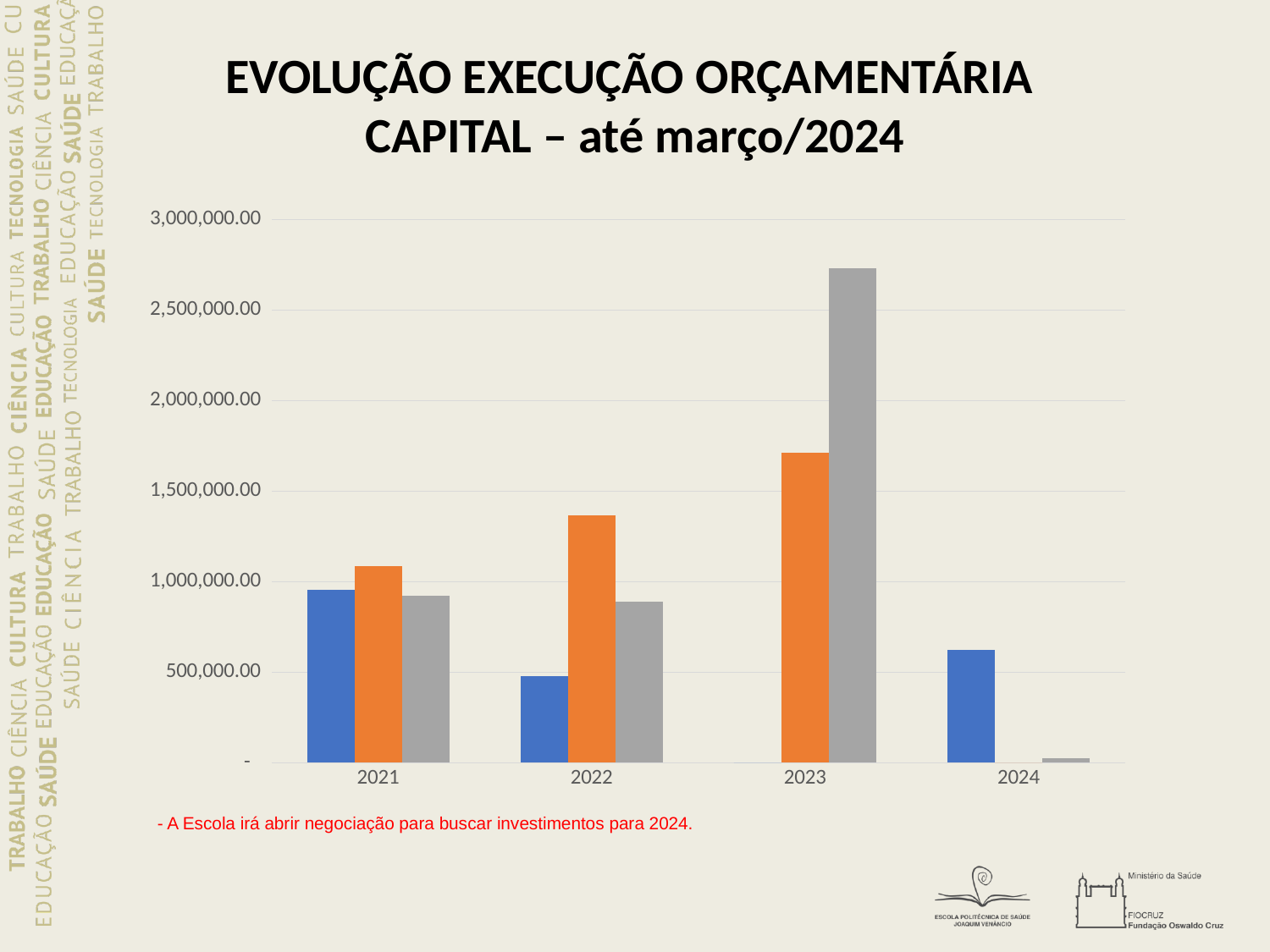
In 2022, which is larger: the orange bar or the gray bar? the orange bar What is the title of the chart on the slide? EVOLUÇÃO EXECUÇÃO ORÇAMENTÁRIA CAPITAL – até março/2024 Which year contains the tallest bar in the chart? 2023 What kind of chart is shown on the slide? bar chart Is the value of the gray bar for 2023 greater or less than 2,500,000.00? greater How many years are shown on the x axis of the chart? 4 Do the orange bars rise or fall from 2021 to 2023? rise Is the value of the orange bar for 2023 greater or less than 1,500,000.00? greater In 2023, which is larger: the orange bar or the gray bar? the gray bar Which year has the tallest blue bar? 2021 Is the value of the blue bar for 2024 greater or less than 500,000.00? greater